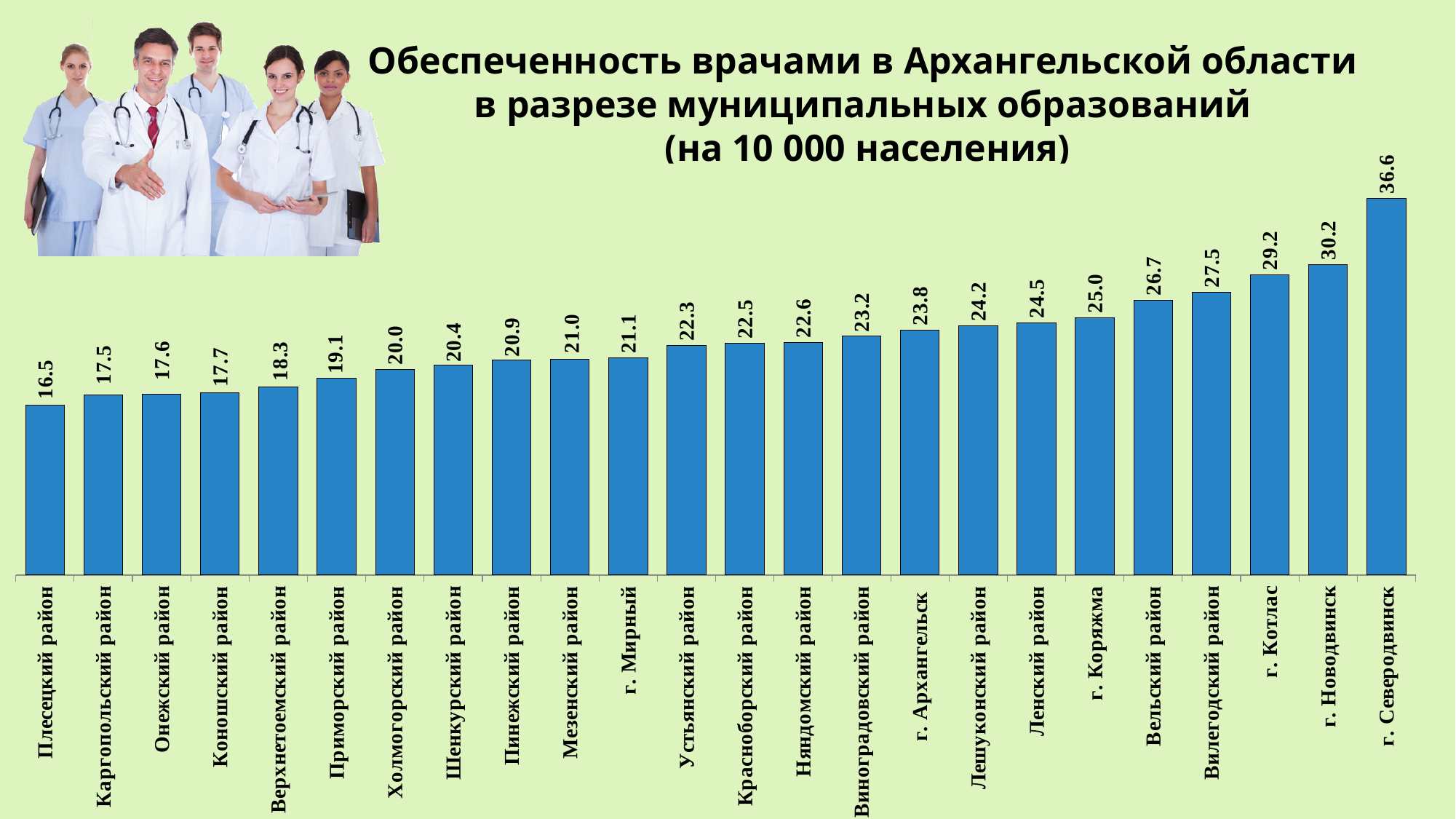
What is the value for г. Архангельск? 23.8 Which municipality has the lowest value? Плесецкий район Which municipality has the highest value? г. Северодвинск What is the value for Приморский район? 19.1 How many municipalities are shown in the chart? 24 What kind of chart is shown on the slide? bar chart Do the values rise or fall from left to right along the x axis? rise What is the title of the chart? Обеспеченность врачами в Архангельской области в разрезе муниципальных образований (на 10 000 населения) What is the difference between the values for Вельский район and Плесецкий район? 10.2 What is the difference between the values for г. Северодвинск and г. Новодвинск? 6.4 Which is larger, the value for г. Коряжма or the value for Ленский район? г. Коряжма What is the value for г. Котлас? 29.2